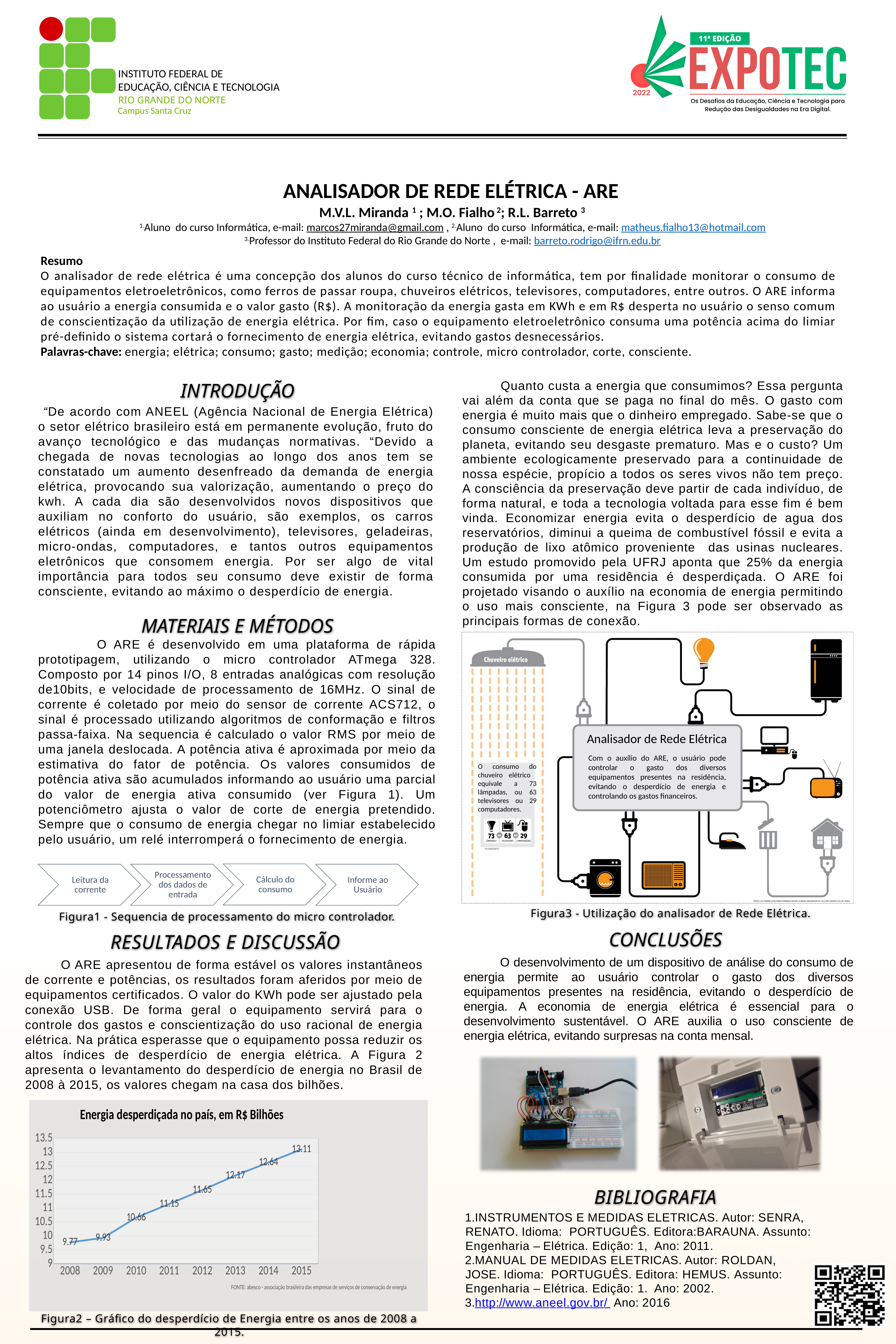
Is the value for 2011 in the chart greater or less than 11? greater What is the title of the chart on the slide? Energia desperdiçada no país, em R$ Bilhões How many years are plotted on the x axis of the chart? 8 Which is larger in the chart, the value for 2010 or the value for 2013? 2013 What kind of chart is shown under 'Energia desperdiçada no país, em R$ Bilhões'? line chart What is the value plotted for 2012 in the chart? 11.65 Which year has the highest value in the chart? 2015 What is the difference between the values for 2015 and 2008 in the chart? 3.34 What is the value plotted for 2015 in the chart? 13.11 Which year has the lowest value in the chart? 2008 Do the values in the chart rise or fall from 2008 to 2015? rise What is the value plotted for 2008 in the chart? 9.77